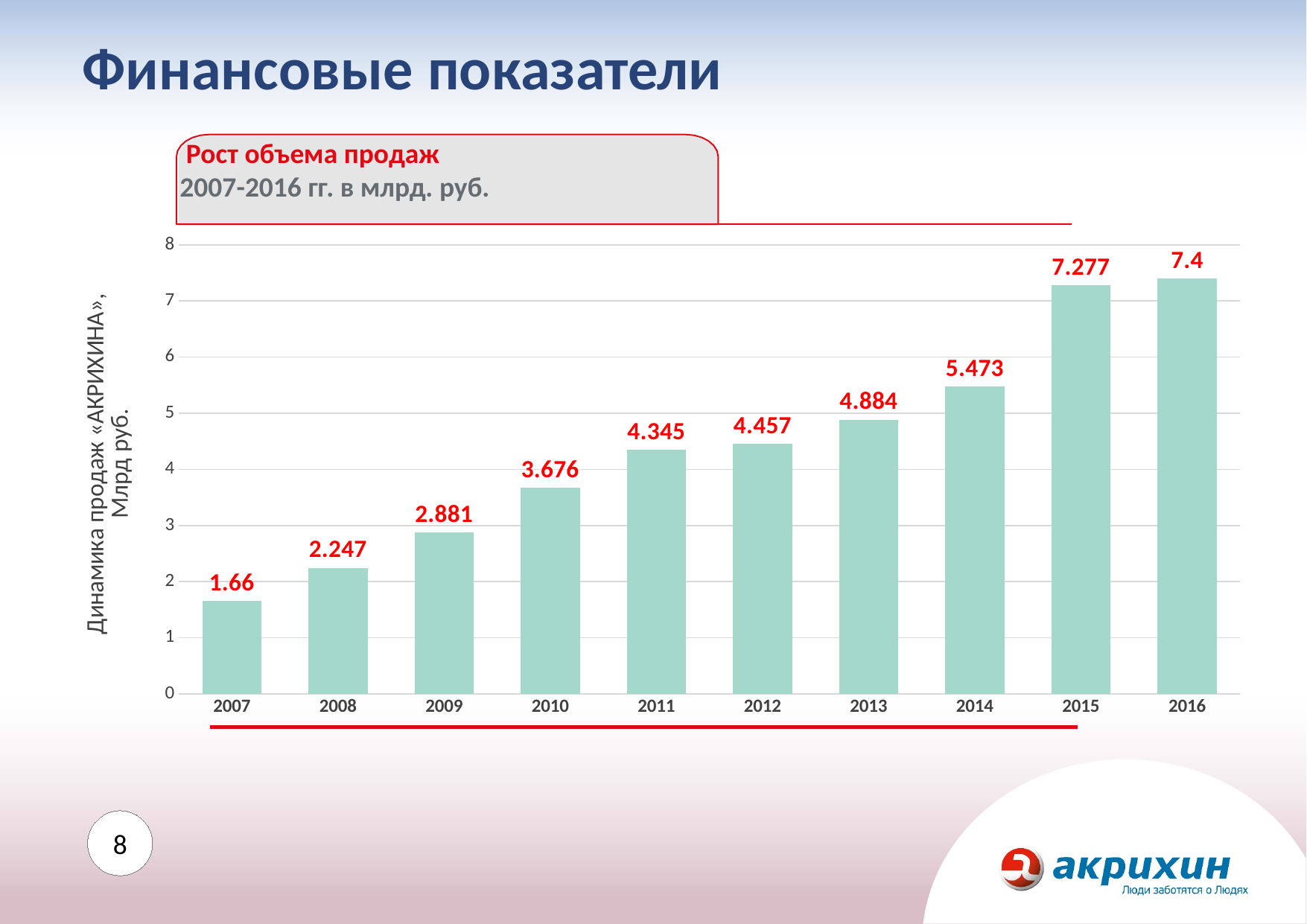
How many years are shown on the x axis of the chart? 10 Is the value for 2009 greater or less than 3? less What is the sales volume for 2007? 1.66 What is the sales volume for 2014? 5.473 Do the sales volumes rise or fall from 2007 to 2016? rise Which year has the lowest sales volume? 2007 Which year has a larger sales volume, 2012 or 2013? 2013 What is the sales volume for 2010? 3.676 What unit is given in the chart's title box for the sales volume? млрд. руб. What kind of chart is shown on the slide? bar chart Which year has the highest sales volume? 2016 What is the difference between the sales volume in 2015 and in 2014? 1.804